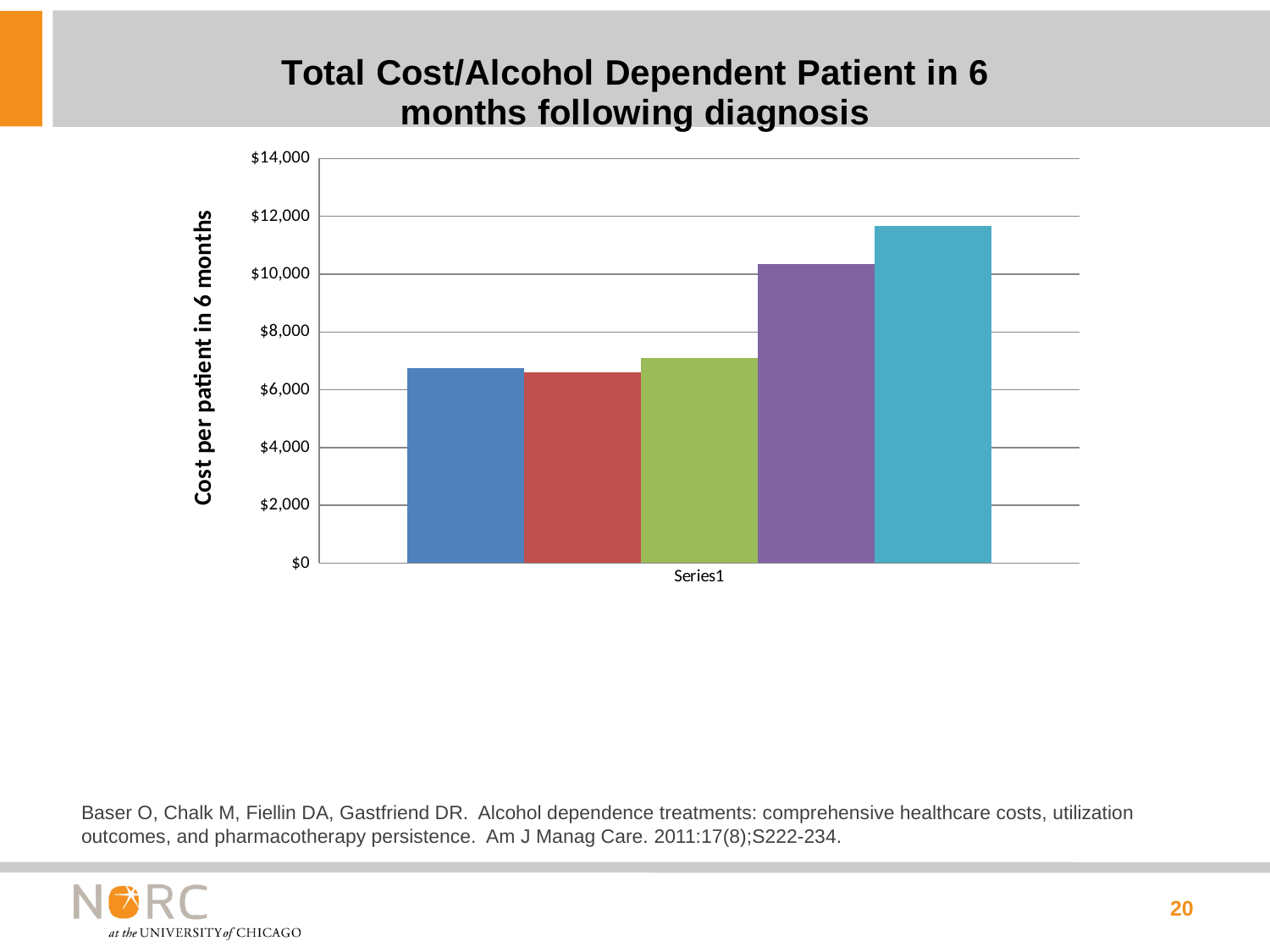
What label appears under the bars on the horizontal axis? Series1 Which is larger, the light blue (rightmost) bar or the purple bar? the light blue bar Is the value of the light blue (rightmost) bar greater or less than $12,000? less How many bars are plotted in the chart? 5 Is the value of the purple bar greater or less than $8,000? greater What kind of chart is shown on the slide? bar chart Is the value of the blue (leftmost) bar greater or less than $6,000? greater What is the title of the chart's vertical axis? Cost per patient in 6 months Which bar is the tallest in the chart? the light blue (rightmost) bar Which is larger, the purple bar or the green bar? the purple bar